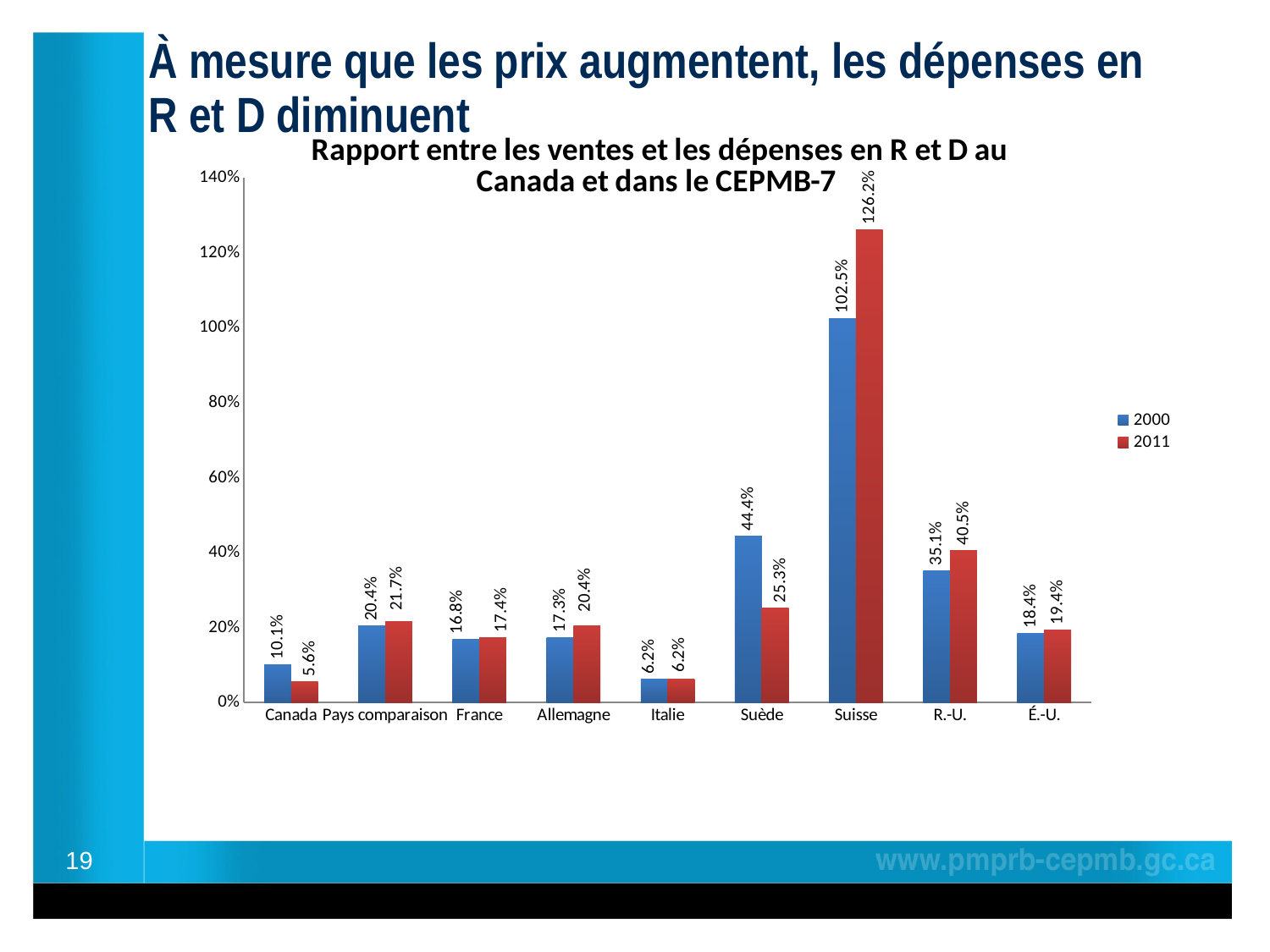
Is the 2000 value for Suisse greater or less than 100%? greater Which category has the highest value in the 2011 series? Suisse How many categories are shown on the x axis? 9 What kind of chart is shown on the slide? bar chart What is the value for Suisse in the 2011 series? 126.2% Which is larger for Suède: the 2000 value or the 2011 value? 2000 What is the value for R.-U. in the 2011 series? 40.5% What is the value for Canada in the 2000 series? 10.1% What is the value for Suède in the 2000 series? 44.4% Which category has the lowest value in the 2011 series? Canada How many series does the legend list? 2 What is the difference between the 2011 and 2000 values for Suisse? 23.7%